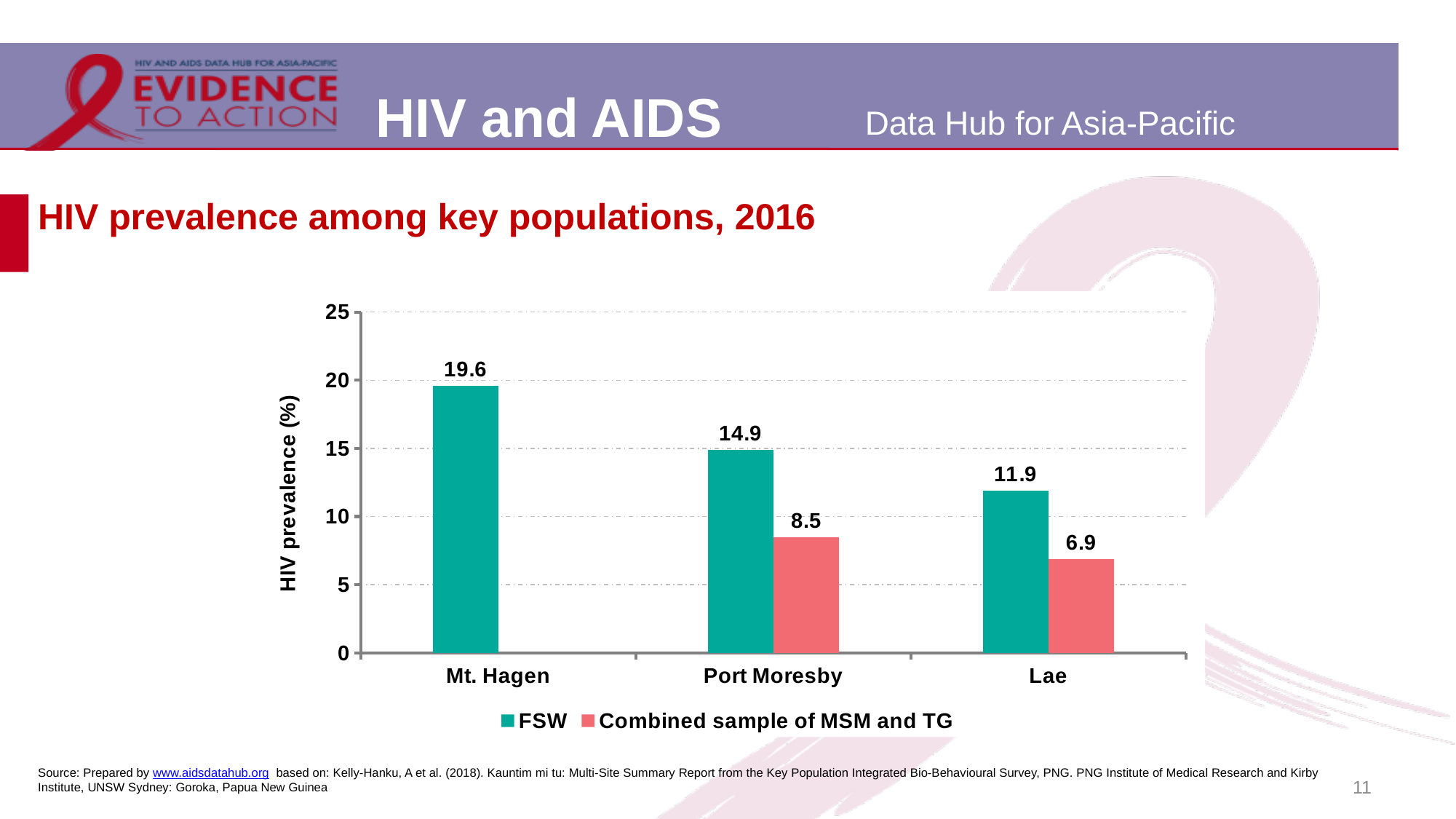
What is the HIV prevalence among FSW in Lae? 11.9 What is the label of the y axis of the chart? HIV prevalence (%) What type of chart is shown on the slide? Bar chart Is the FSW HIV prevalence in Port Moresby greater or less than 10? greater Which city has the highest HIV prevalence among FSW? Mt. Hagen What is the HIV prevalence for the combined sample of MSM and TG in Port Moresby? 8.5 Which city has the lowest HIV prevalence for the combined sample of MSM and TG? Lae What is the HIV prevalence among FSW in Mt. Hagen? 19.6 How many series does the chart legend list? 2 What is the difference between the FSW HIV prevalence in Port Moresby and the combined MSM and TG prevalence in Port Moresby? 6.4 Which is larger in Lae: the HIV prevalence among FSW or among the combined sample of MSM and TG? FSW How many cities are shown on the x axis of the chart? 3